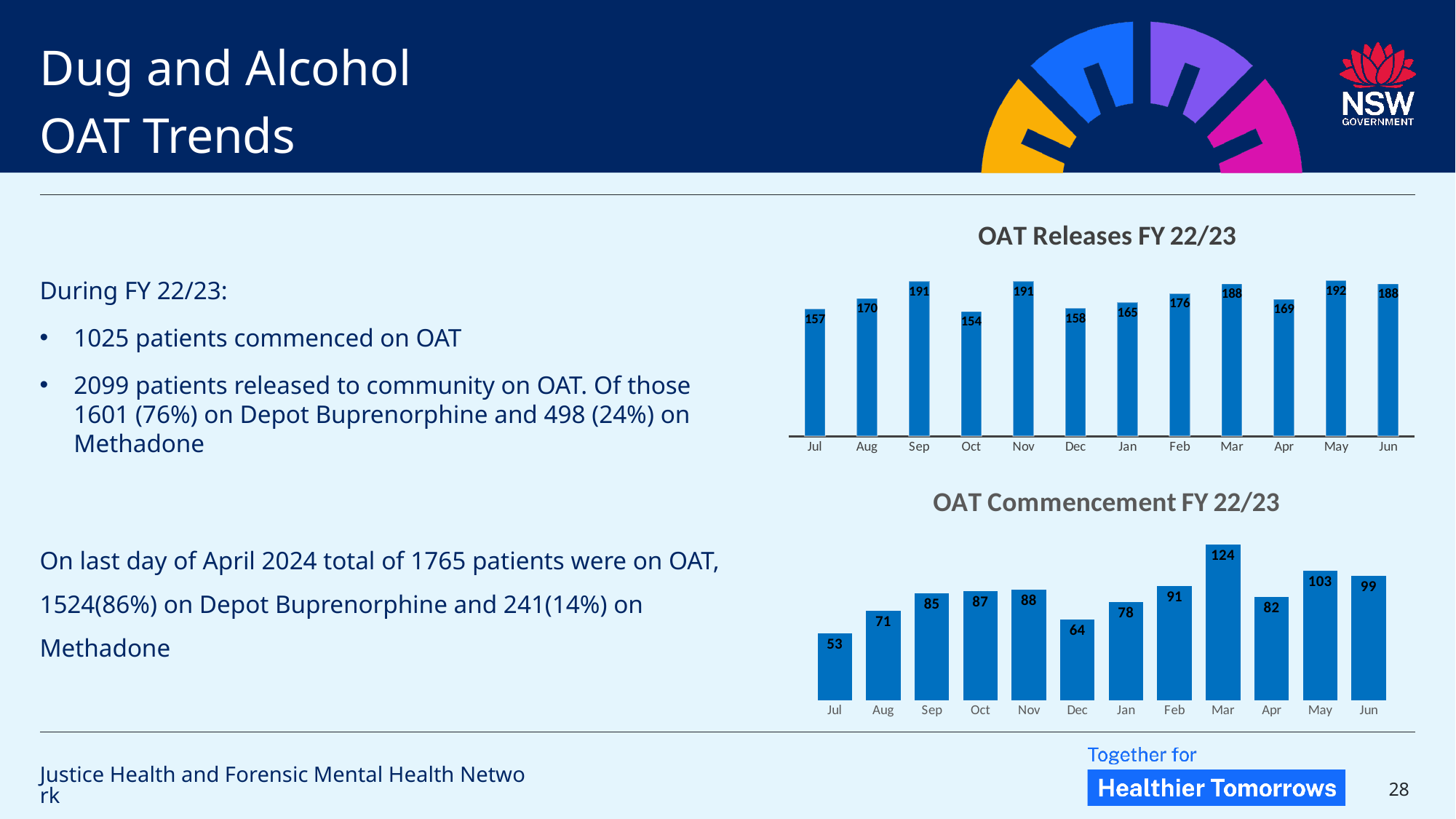
In the OAT Releases FY 22/23 chart, what is the difference between the values for May and Jul? 35 What kind of chart is the OAT Releases FY 22/23 chart? Bar chart In the OAT Commencement FY 22/23 chart, which is larger, the value for May or the value for Jun? May In the OAT Releases FY 22/23 chart, which is larger, the value for Aug or the value for Dec? Aug In the OAT Commencement FY 22/23 chart, which month has the lowest value? Jul What is the title of the lower chart on the slide? OAT Commencement FY 22/23 How many months are shown in the OAT Commencement FY 22/23 chart? 12 In the OAT Releases FY 22/23 chart, what is the value for Oct? 154 In the OAT Commencement FY 22/23 chart, what is the value for Mar? 124 In the OAT Releases FY 22/23 chart, which month has the lowest value? Oct In the OAT Commencement FY 22/23 chart, what is the difference between the values for Mar and Dec? 60 In the OAT Releases FY 22/23 chart, which month has the highest value? May